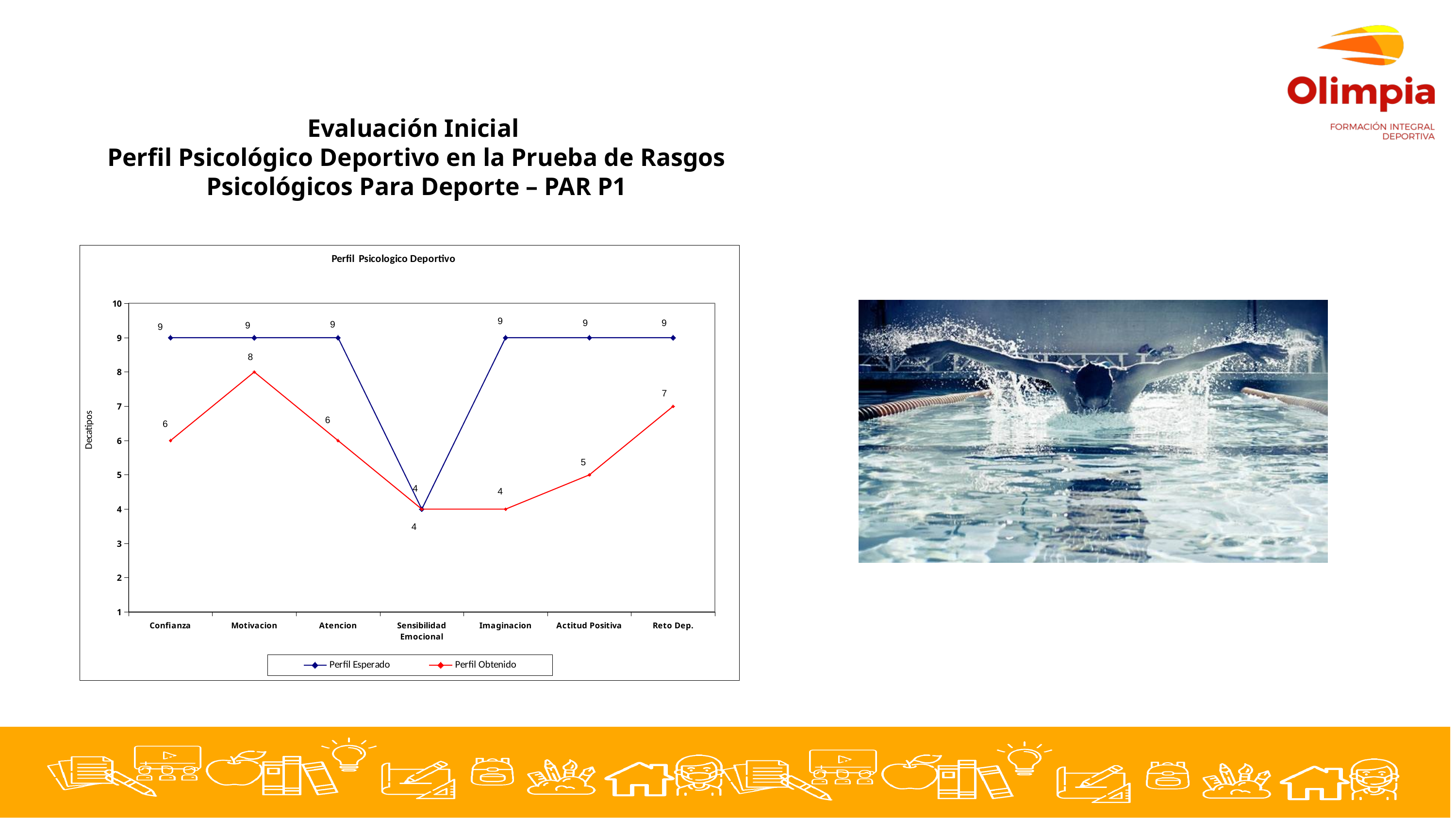
How many series does the legend list? 2 What is the Perfil Esperado value for Confianza? 9 How many categories are shown on the x axis? 7 What kind of chart is shown? Line chart What is the Perfil Obtenido value for Reto Dep.? 7 Which category has the highest Perfil Obtenido value? Motivacion What is the Perfil Obtenido value for Motivacion? 8 Which is larger for Atencion: Perfil Esperado or Perfil Obtenido? Perfil Esperado Which category has the lowest Perfil Esperado value? Sensibilidad Emocional What is the y-axis label of the chart? Decatipos What is the difference between Perfil Esperado and Perfil Obtenido for Imaginacion? 5 What is the Perfil Obtenido value for Actitud Positiva? 5